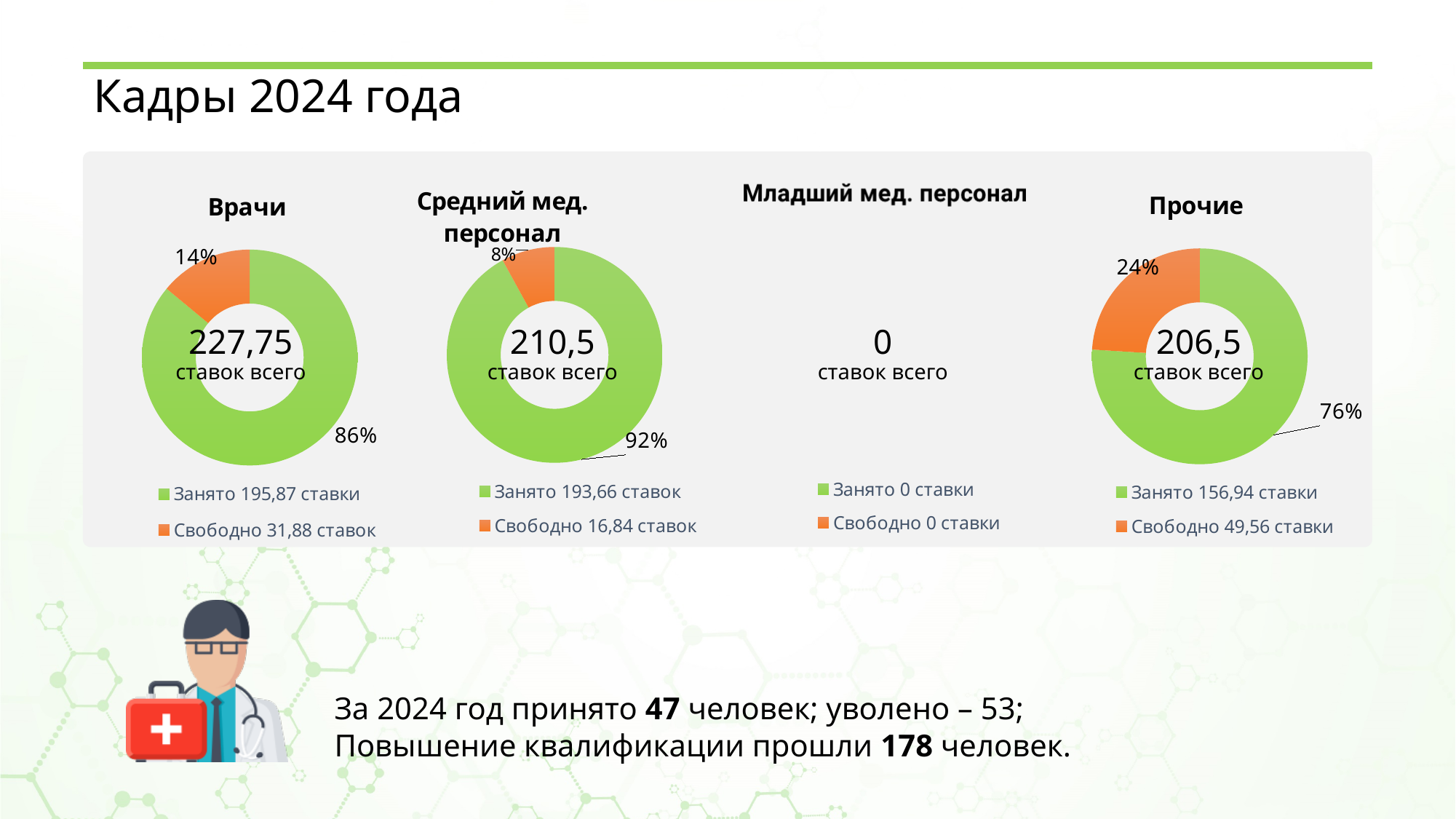
On the Прочие chart, what is the total number of positions (ставок всего) shown in the centre? 206,5 Which has more occupied positions (Занято): the Врачи chart or the Прочие chart? Врачи On the Врачи chart, how many positions are listed as Свободно in the legend? 31,88 ставок What type of chart is used for the Врачи data? Pie (donut) chart On the Средний мед. персонал chart, how many positions are listed as Занято in the legend? 193,66 ставок On the Младший мед. персонал chart, what is the total number of positions (ставок всего) shown? 0 On the Прочие chart, what percentage of positions is shown as free (Свободно)? 24% On the Средний мед. персонал chart, what percentage of positions is shown as free (Свободно)? 8% How many entries does the legend of the Врачи chart list? 2 Which chart shows the highest total number of positions (ставок всего)? Врачи On the Врачи chart, what percentage of positions is shown as occupied (Занято)? 86%